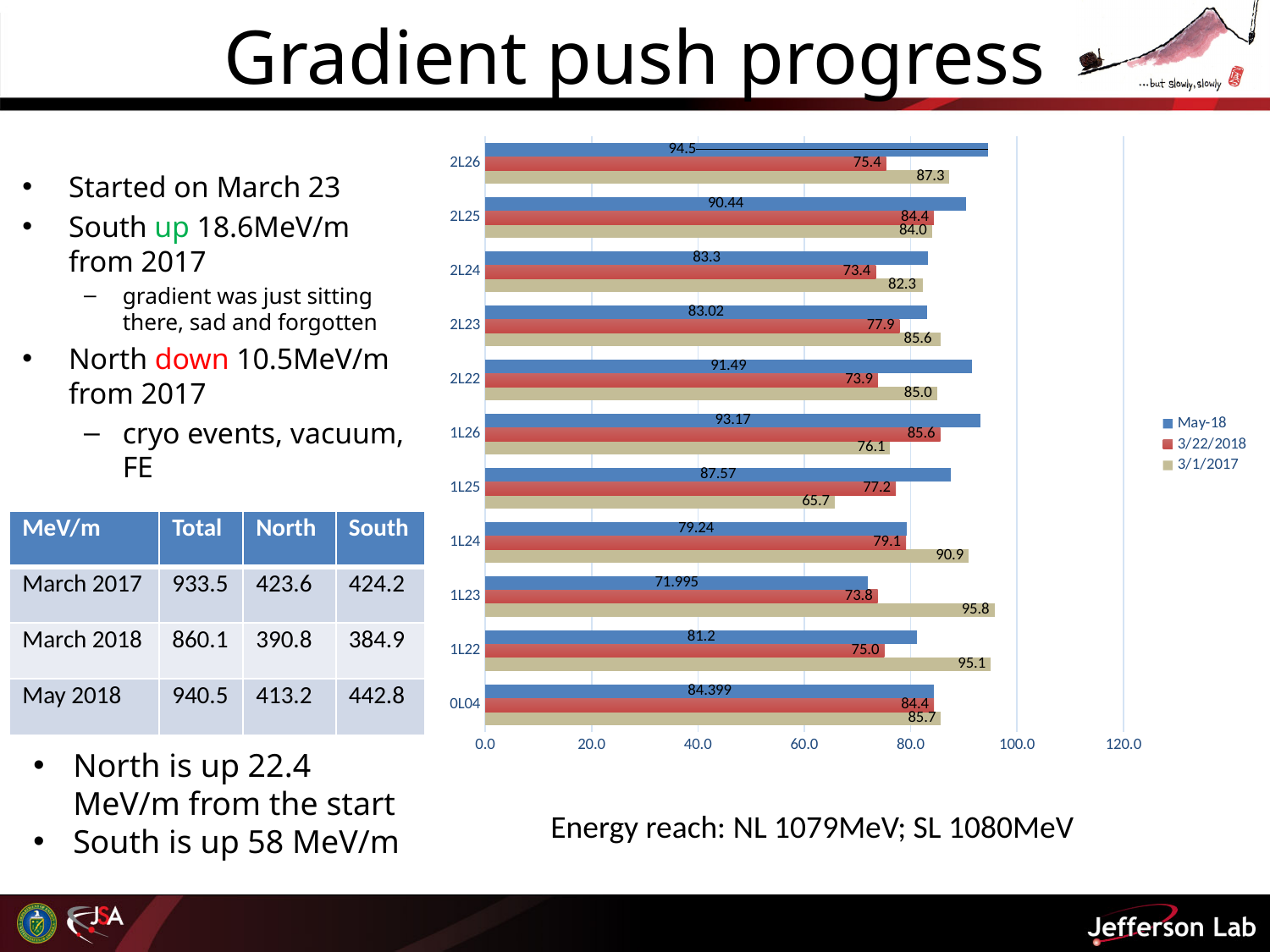
Which category has the highest May-18 value? 2L26 What is the difference between the May-18 and 3/22/2018 values for 2L26? 19.1 For 1L24, which is larger: the May-18 value or the 3/1/2017 value? 3/1/2017 How many series does the chart legend list? 3 Which category has the lowest May-18 value? 1L23 What is the 3/22/2018 value for 1L26? 85.6 Which category has the highest 3/1/2017 value? 1L23 Which series is shown in blue in the legend? May-18 What is the May-18 value for 2L26? 94.5 What kind of chart is shown on the slide? bar chart How many cryomodule categories are plotted on the chart? 11 What is the 3/1/2017 value for 1L25? 65.7